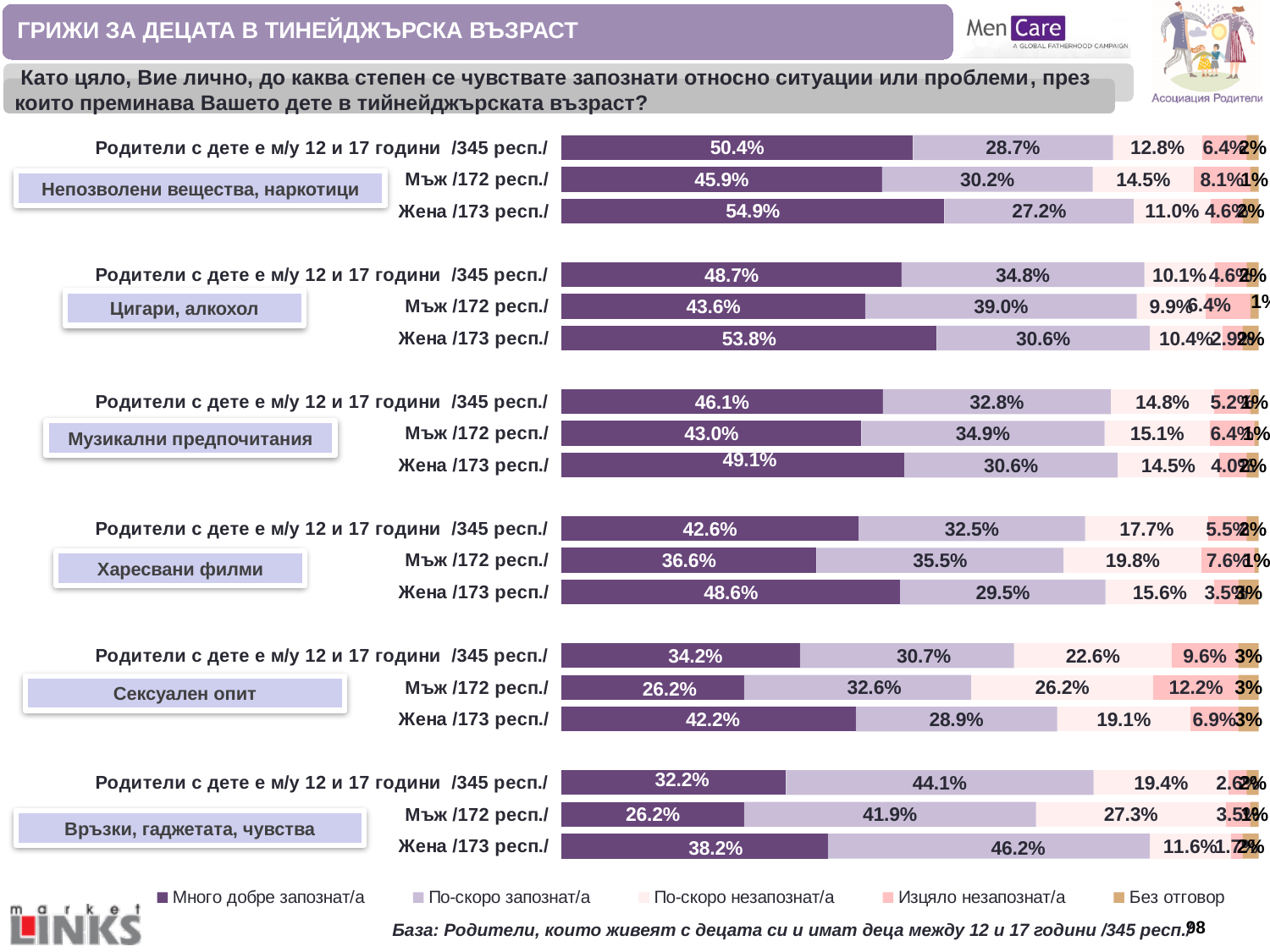
Among the rows for Родители с дете е м/у 12 и 17 години /345 респ./, which topic group has the lowest value of Много добре запознат/а? Връзки, гаджетата, чувства How many series does the legend list? 5 In the group Непозволени вещества, наркотици, what is the value of Много добре запознат/а for Жена /173 респ./? 54.9% In the group Връзки, гаджетата, чувства, what is the value of По-скоро запознат/а for Жена /173 респ./? 46.2% In the group Сексуален опит, what is the value of Изцяло незапознат/а for Мъж /172 респ./? 12.2% In the group Цигари, алкохол, which has the larger value of По-скоро запознат/а: Мъж /172 респ./ or Жена /173 респ./? Мъж /172 респ./ Among the rows for Родители с дете е м/у 12 и 17 години /345 респ./, which topic group has the highest value of Много добре запознат/а? Непозволени вещества, наркотици In the group Връзки, гаджетата, чувства, what is the value of По-скоро незапознат/а for Мъж /172 респ./? 27.3% In the group Харесвани филми, what is the difference between the Много добре запознат/а values for Жена /173 респ./ and Мъж /172 респ./? 12.0 percentage points In the group Сексуален опит, what is the value of Много добре запознат/а for Мъж /172 респ./? 26.2% How many topic groups (e.g. Непозволени вещества, наркотици; Цигари, алкохол) are shown on the chart? 6 What kind of chart is shown on the slide? Stacked horizontal bar chart